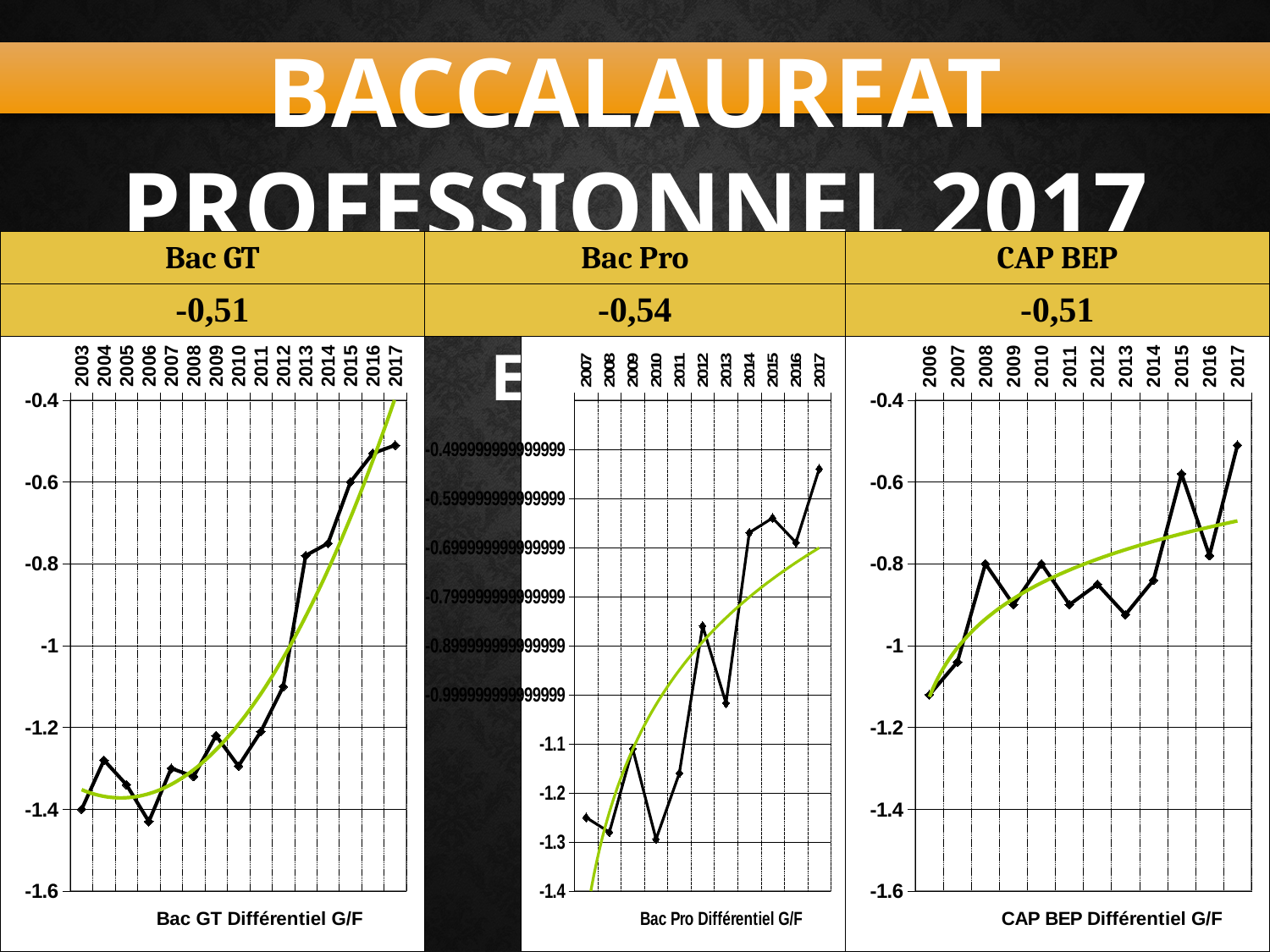
On the Bac GT Différentiel G/F chart, is the value for 2003 greater or less than -1.2? less On the Bac GT Différentiel G/F chart, which year has the highest value? 2017 On the CAP BEP Différentiel G/F chart, is the value for 2015 larger or smaller than the value for 2016? larger What kind of chart is the Bac GT Différentiel G/F chart on the left? line chart On the Bac Pro Différentiel G/F chart, which year has the highest value? 2017 On the CAP BEP Différentiel G/F chart, which year has the lowest value? 2006 How many charts are shown on the slide? 3 How many years are plotted on the Bac GT Différentiel G/F chart? 15 On the Bac GT Différentiel G/F chart, do the values generally rise or fall from 2003 to 2017? rise How many years are plotted on the Bac Pro Différentiel G/F chart? 11 On the Bac GT Différentiel G/F chart, which year has the lowest value? 2006 How many years are plotted on the CAP BEP Différentiel G/F chart? 12